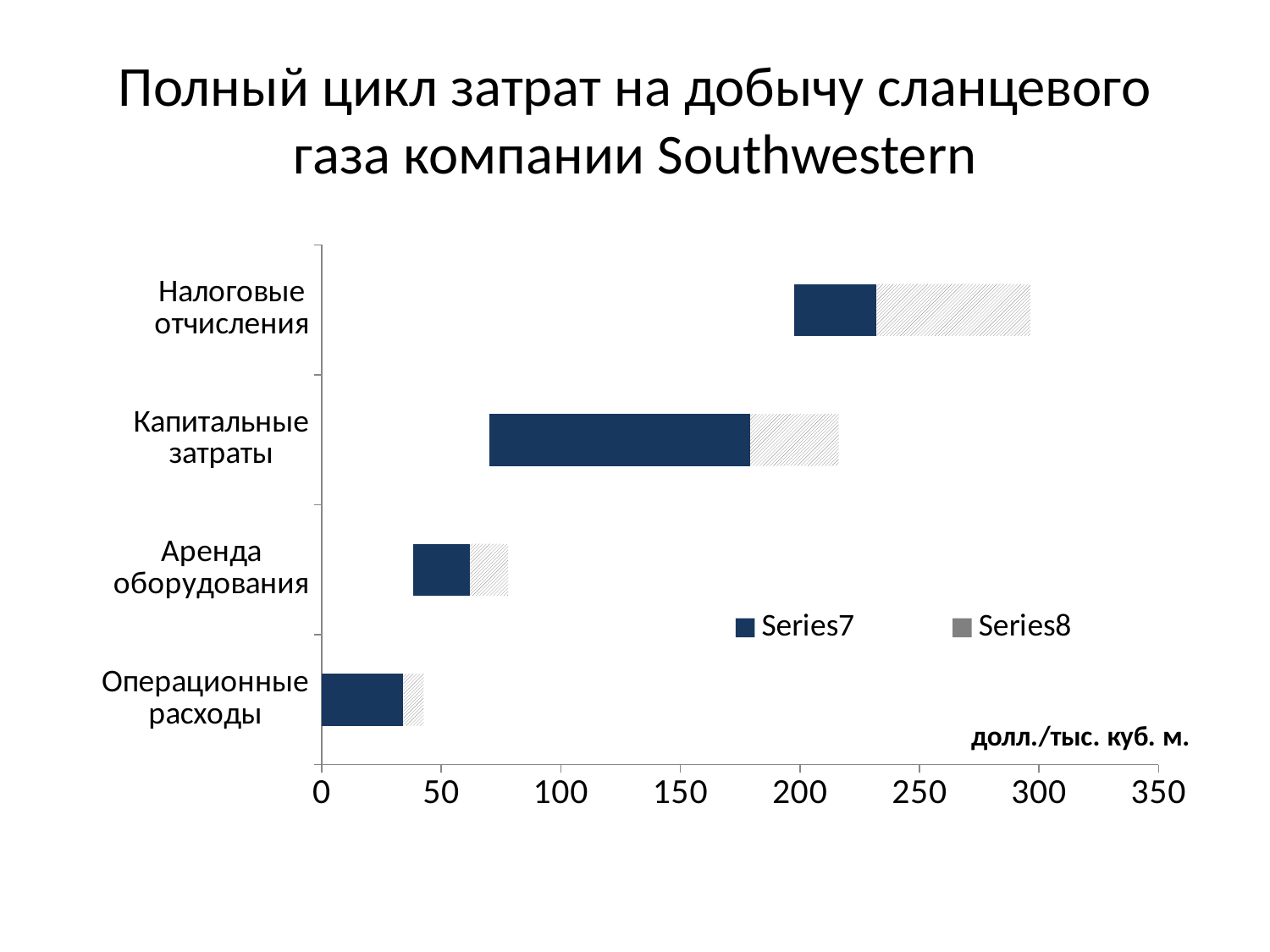
Is the right end of the bar for Капитальные затраты greater or less than 200? greater Is the right end of the bar for Операционные расходы greater or less than 50? less What unit is shown on the horizontal axis of the chart? долл./тыс. куб. м. How many series does the legend list? 2 What are the two legend entries of the chart? Series7 and Series8 What kind of chart is shown on the slide? bar chart How many cost categories are shown on the chart? 4 Is the right end of the bar for Налоговые отчисления greater or less than 250? greater Does the bar for Капитальные затраты extend further to the right than the bar for Аренда оборудования? Yes Which category has the longest dark (Series7) bar segment? Капитальные затраты